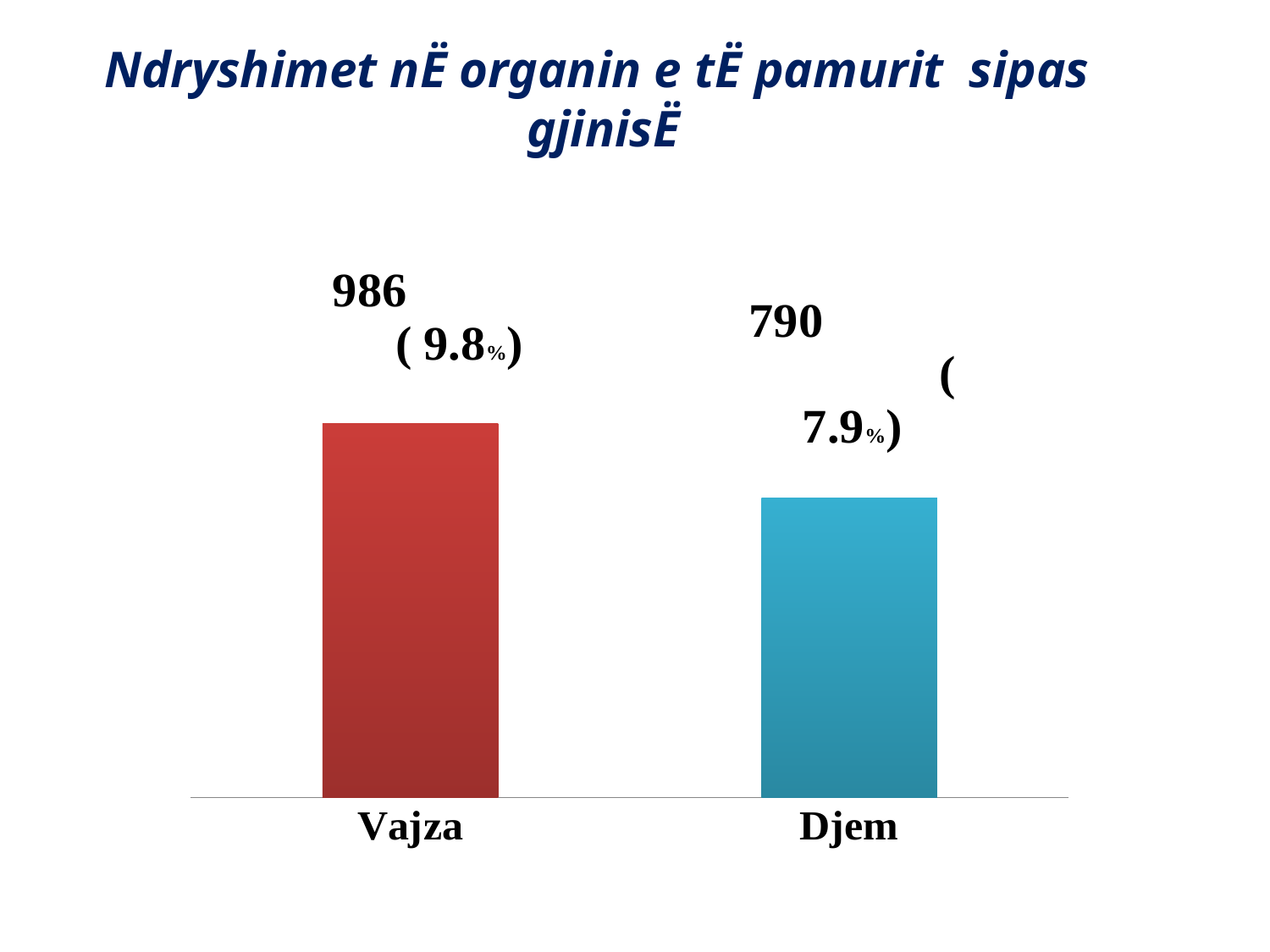
What is the title of the slide? Ndryshimet nË organin e tË pamurit sipas gjinisË What is the difference between the values for Vajza and Djem? 196 Which is larger, the value for Vajza or the value for Djem? Vajza What percentage is shown for Vajza? 9.8% What colour is the bar for Djem? Blue What kind of chart is shown on the slide? Bar chart How many categories are shown in the chart? 2 What percentage is shown for Djem? 7.9% What is the value for Djem? 790 What is the value for Vajza? 986 Which category has the highest value? Vajza Which category has the lowest value? Djem